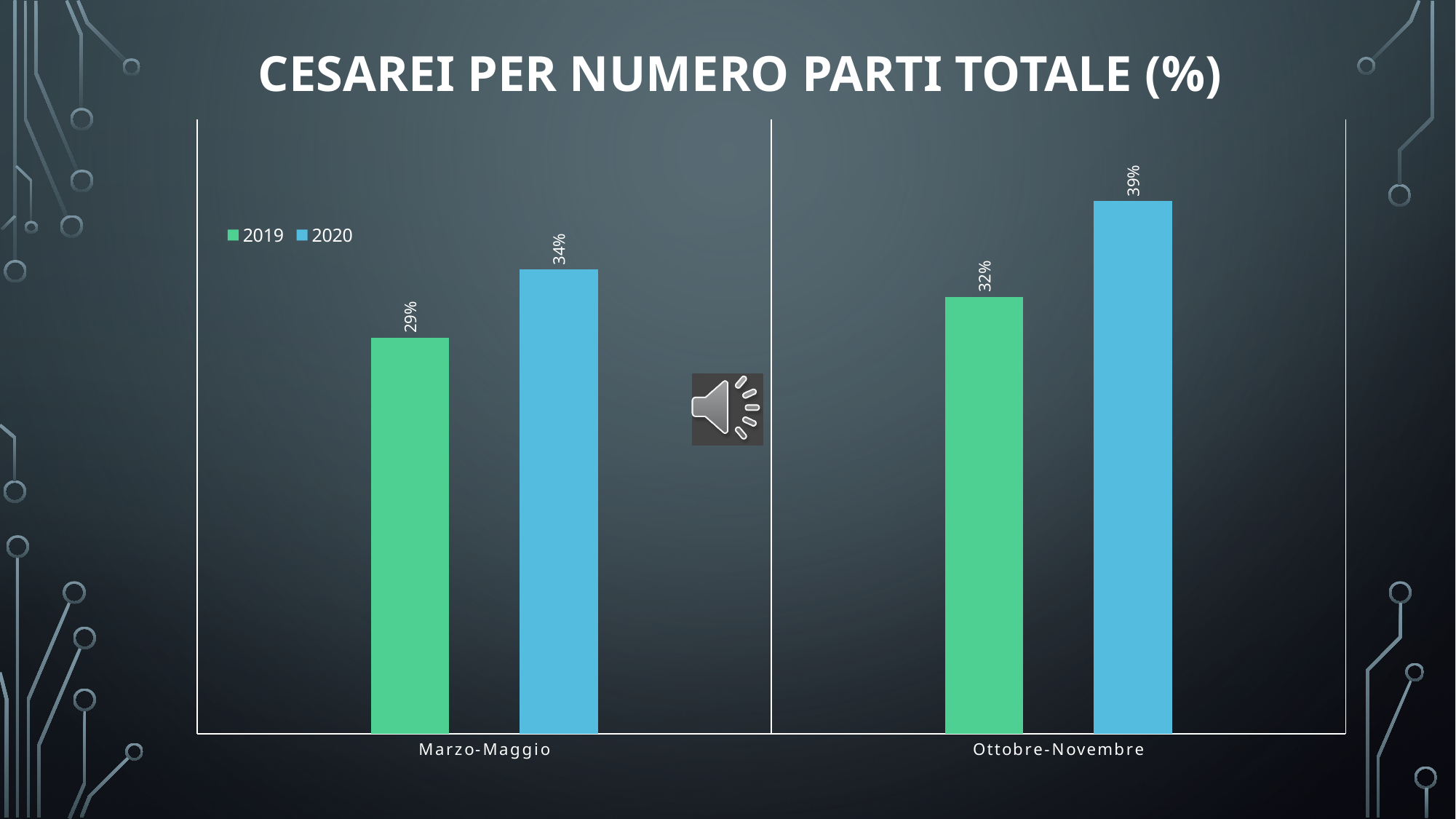
Which is larger: the 2019 value in Ottobre-Novembre or the 2020 value in Marzo-Maggio? 2020 value in Marzo-Maggio How many series does the legend list? 2 How many categories are shown on the x axis? 2 Which category has the highest value for 2020? Ottobre-Novembre What kind of chart is shown on the slide? Bar chart What is the value for 2019 in Ottobre-Novembre? 32% Which category has the lowest value for 2019? Marzo-Maggio What is the value for 2019 in Marzo-Maggio? 29% What is the difference between the 2020 and 2019 values in Marzo-Maggio? 5% What is the difference between the 2020 and 2019 values in Ottobre-Novembre? 7% What is the value for 2020 in Ottobre-Novembre? 39% What is the value for 2020 in Marzo-Maggio? 34%